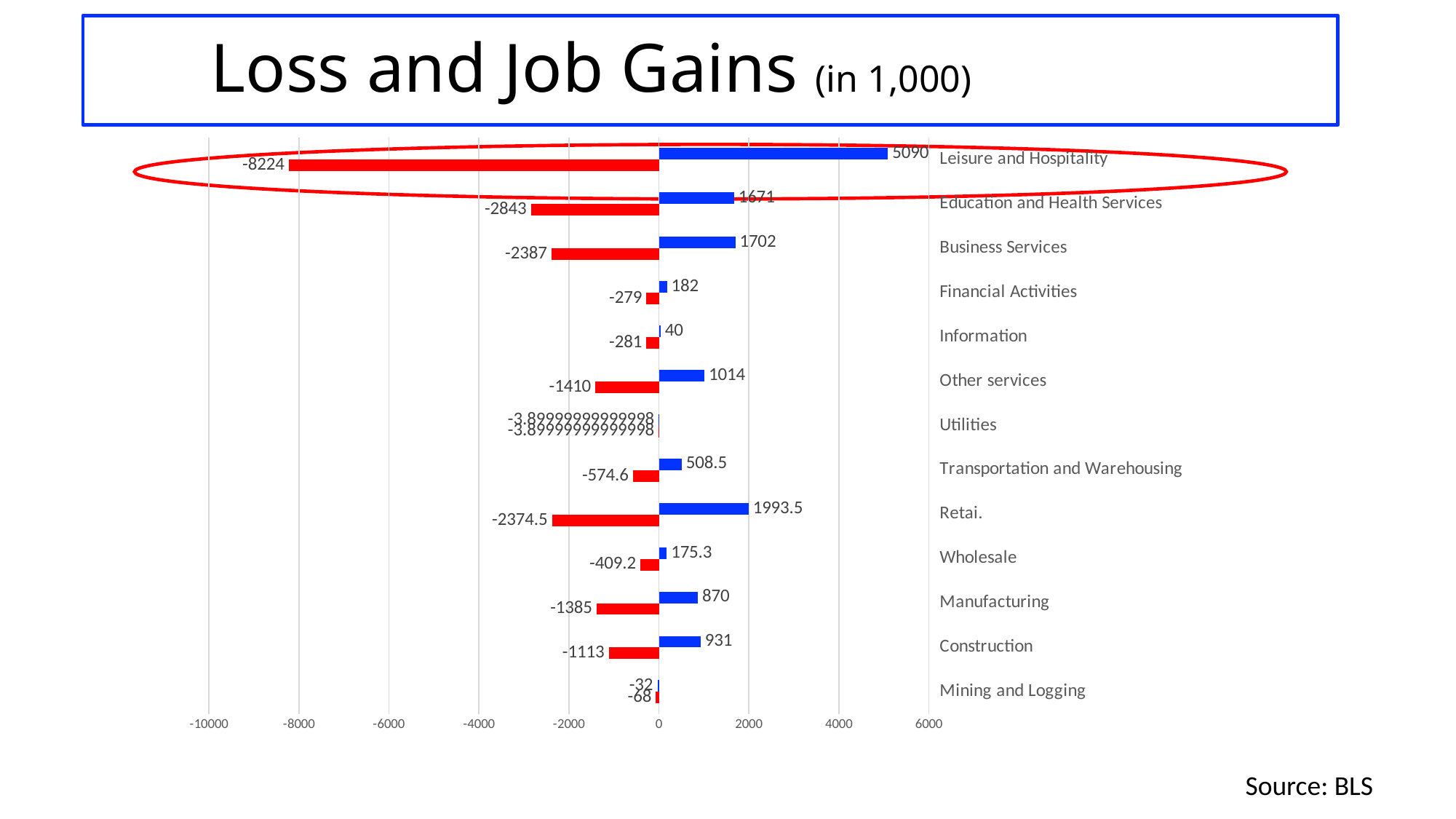
What is the value of the red bar for Transportation and Warehousing? -574.6 What is the title of the slide? Loss and Job Gains (in 1,000) Which has a larger blue bar, Manufacturing or Construction? Construction What is the value of the blue bar for Retai.? 1993.5 What is the value of the blue bar for Information? 40 Which category has the largest blue bar? Leisure and Hospitality What is the difference between the blue bar values for Business Services and Education and Health Services? 31 What type of chart is shown on the slide? bar chart How many categories are shown on the chart? 13 What is the value of the red bar for Wholesale? -409.2 What is the value of the red bar for Leisure and Hospitality? -8224 Which category has the longest red bar (largest loss)? Leisure and Hospitality